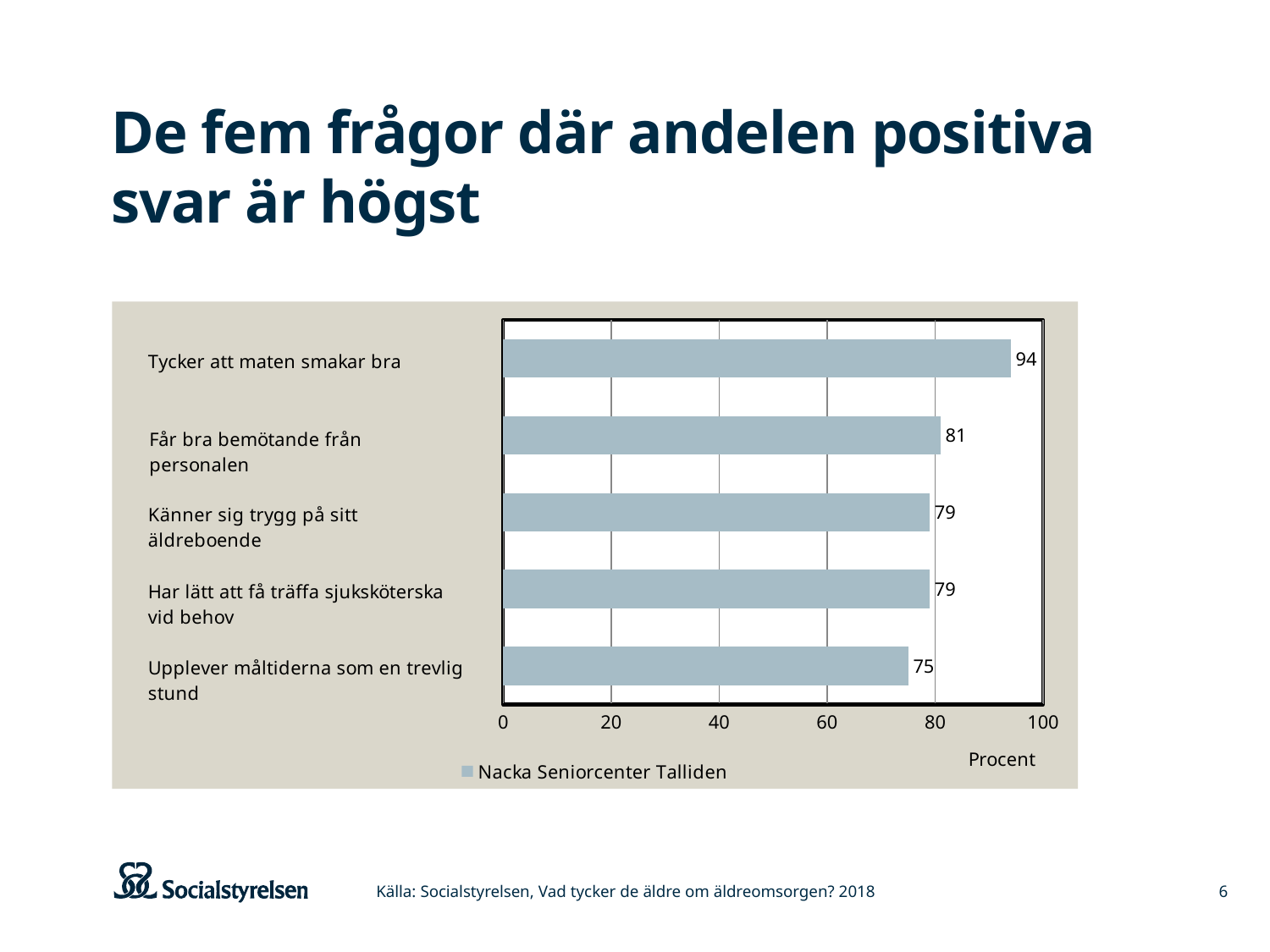
Which is larger: the value for "Får bra bemötande från personalen" or the value for "Har lätt att få träffa sjuksköterska vid behov"? Får bra bemötande från personalen Which category has the highest value? Tycker att maten smakar bra What value is shown for "Känner sig trygg på sitt äldreboende"? 79 How many series does the legend list? 1 How many categories are shown in the chart? 5 Which category has the lowest value? Upplever måltiderna som en trevlig stund What value is shown for "Upplever måltiderna som en trevlig stund"? 75 What is the difference between the values for "Tycker att maten smakar bra" and "Upplever måltiderna som en trevlig stund"? 19 What kind of chart is shown on the slide? Bar chart What value is shown for "Får bra bemötande från personalen"? 81 What series name is shown in the legend? Nacka Seniorcenter Talliden What value is shown for "Tycker att maten smakar bra"? 94